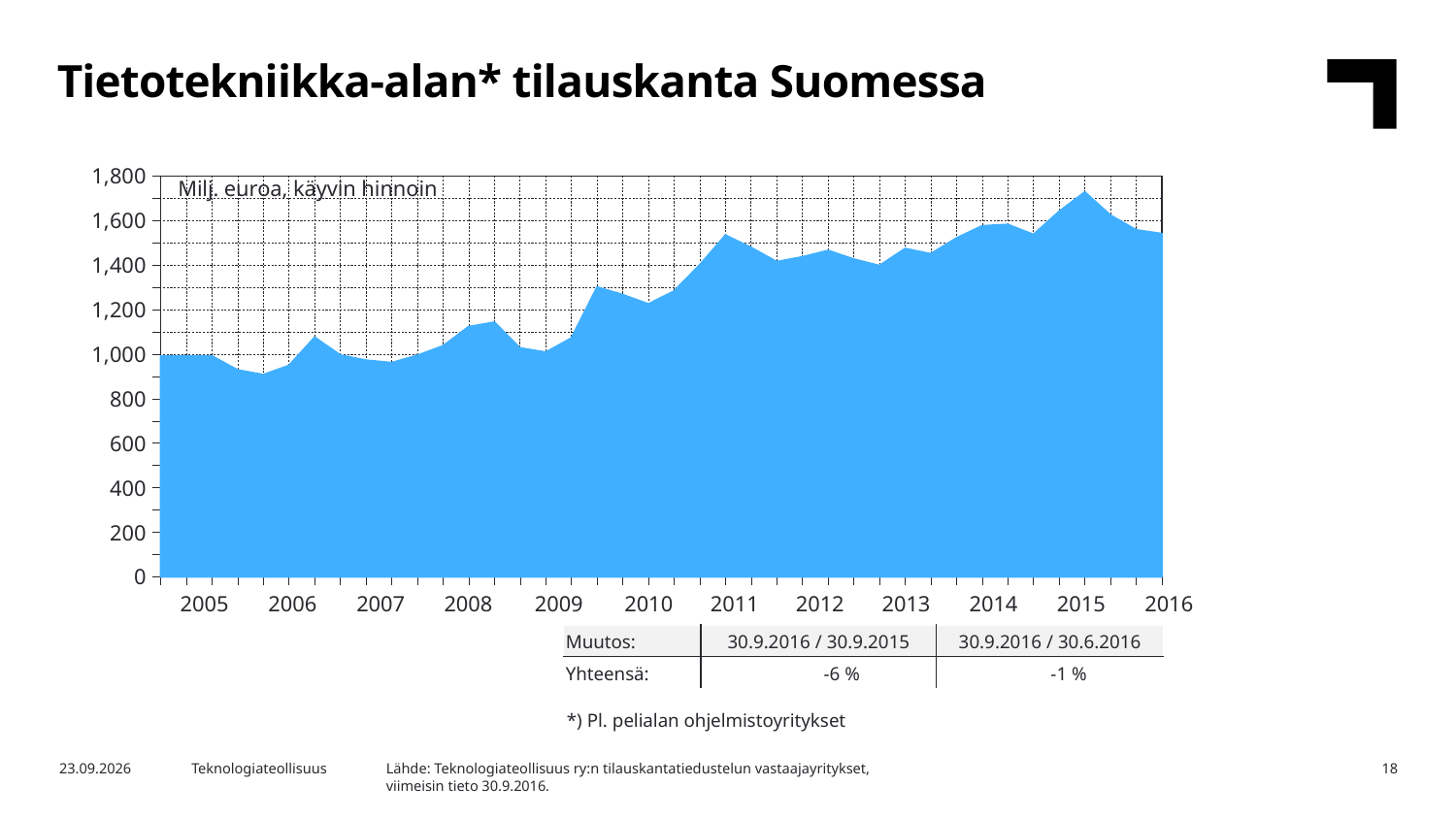
In which year does the chart reach its highest value? 2015 In which year does the chart reach its lowest value? 2006 Is the value at 2006 greater or less than 1,000? less What unit label is printed inside the chart's plot area? Milj. euroa, käyvin hinnoin What is the title of the chart on the slide? Tietotekniikka-alan* tilauskanta Suomessa Which is larger, the value at 2011 or the value at 2007? 2011 Is the value at the 2015 peak greater or less than 1,600? greater How many year labels are shown on the x axis of the chart? 12 Is the value at 2016 greater or less than 1,400? greater Overall, do the values rise or fall from 2005 to 2016? rise What kind of chart is shown on the slide? area chart